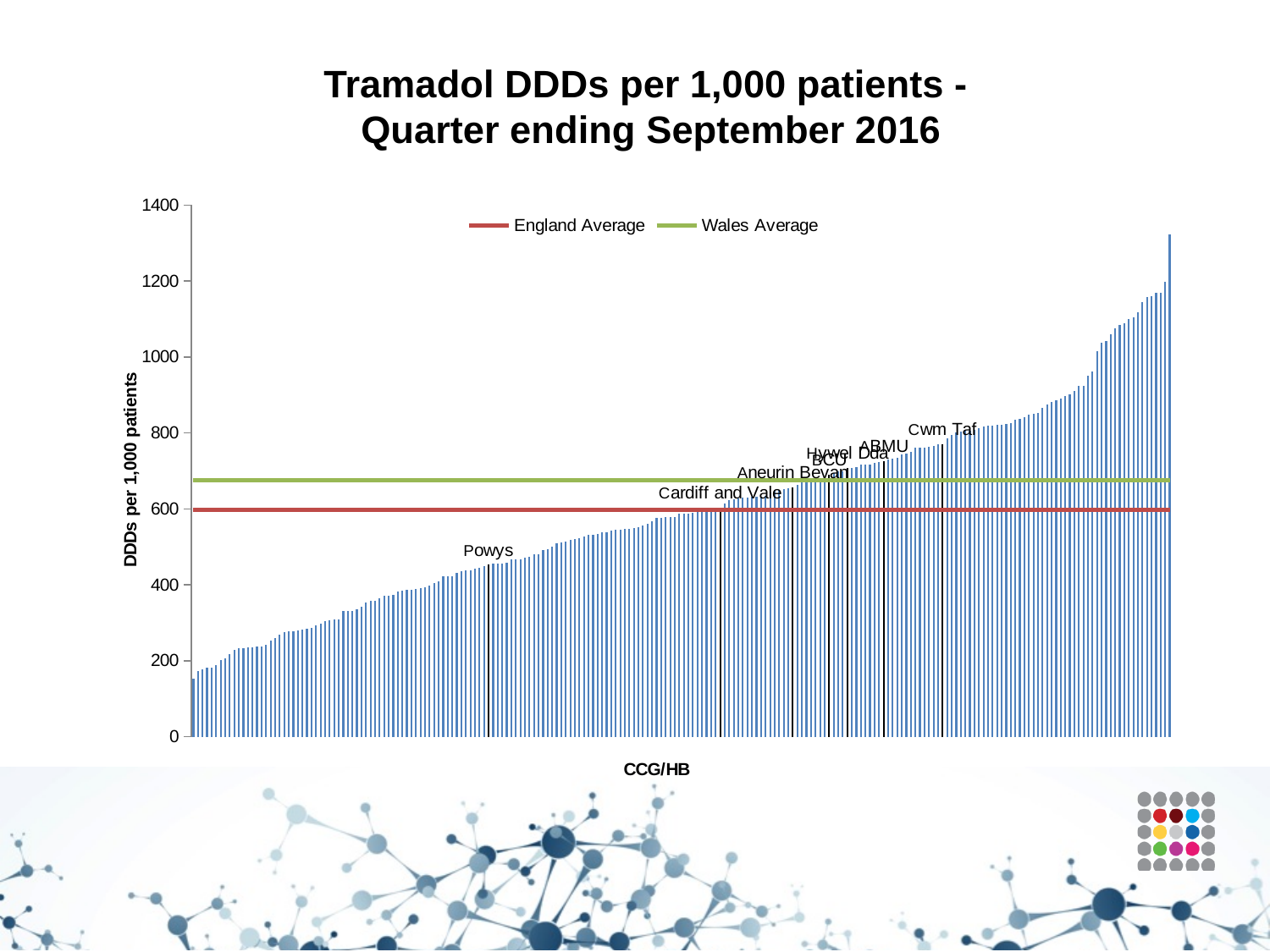
What kind of chart is shown on the slide? bar chart How many entries does the legend list? 2 Which is larger, the value for Cwm Taf or the value for Powys? Cwm Taf Of the labelled health boards, which has the lowest value? Powys Is the England Average line greater or less than 800? less Do the bar values rise or fall from left to right along the x axis? rise What is the title of the chart? Tramadol DDDs per 1,000 patients - Quarter ending September 2016 Is the value for Powys greater or less than 600? less What is the label on the y axis? DDDs per 1,000 patients Is the value for Cwm Taf greater or less than 600? greater Which is higher, the Wales Average line or the England Average line? Wales Average